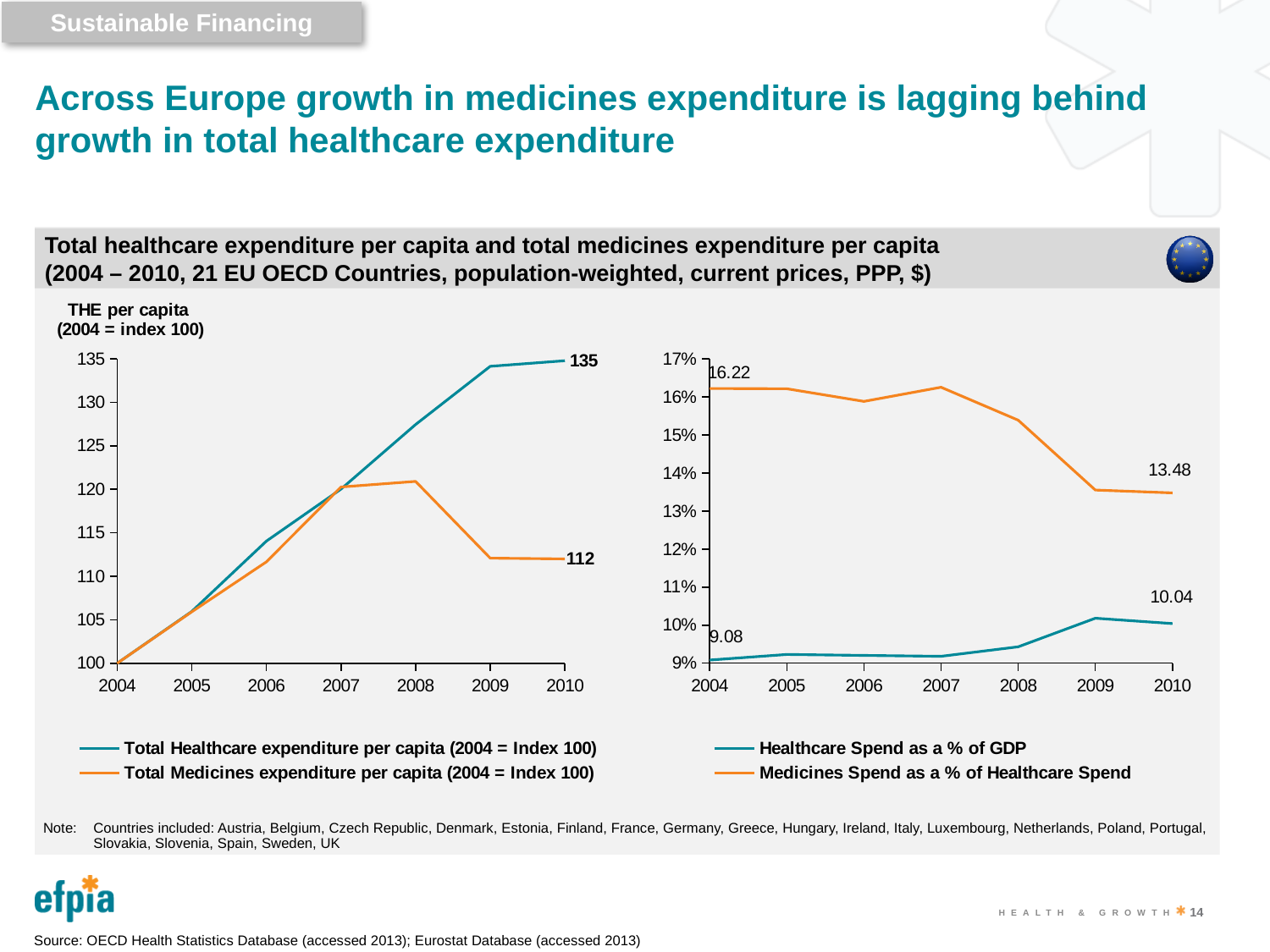
On the right chart, how many series does the legend list? 2 On the left chart, which series has the higher value in 2010, Total Healthcare expenditure per capita or Total Medicines expenditure per capita? Total Healthcare expenditure per capita On the right chart, what is the 2010 value of Healthcare Spend as a % of GDP? 10.04 On the left chart, what is the 2010 value of Total Healthcare expenditure per capita (2004 = Index 100)? 135 On the left chart, what is the 2010 value of Total Medicines expenditure per capita (2004 = Index 100)? 112 On the left chart, what is the difference between the 2010 values of Total Healthcare expenditure per capita and Total Medicines expenditure per capita? 23 On the right chart, what is the 2010 value of Medicines Spend as a % of Healthcare Spend? 13.48 On the right chart, what is the 2004 value of Medicines Spend as a % of Healthcare Spend? 16.22 On the left chart, how many years are shown on the x axis? 7 On the right chart, does Medicines Spend as a % of Healthcare Spend rise or fall from 2004 to 2010? fall On the left chart, is the value for Total Medicines expenditure per capita in 2008 greater or less than 115? greater What kind of chart is the left chart? line chart